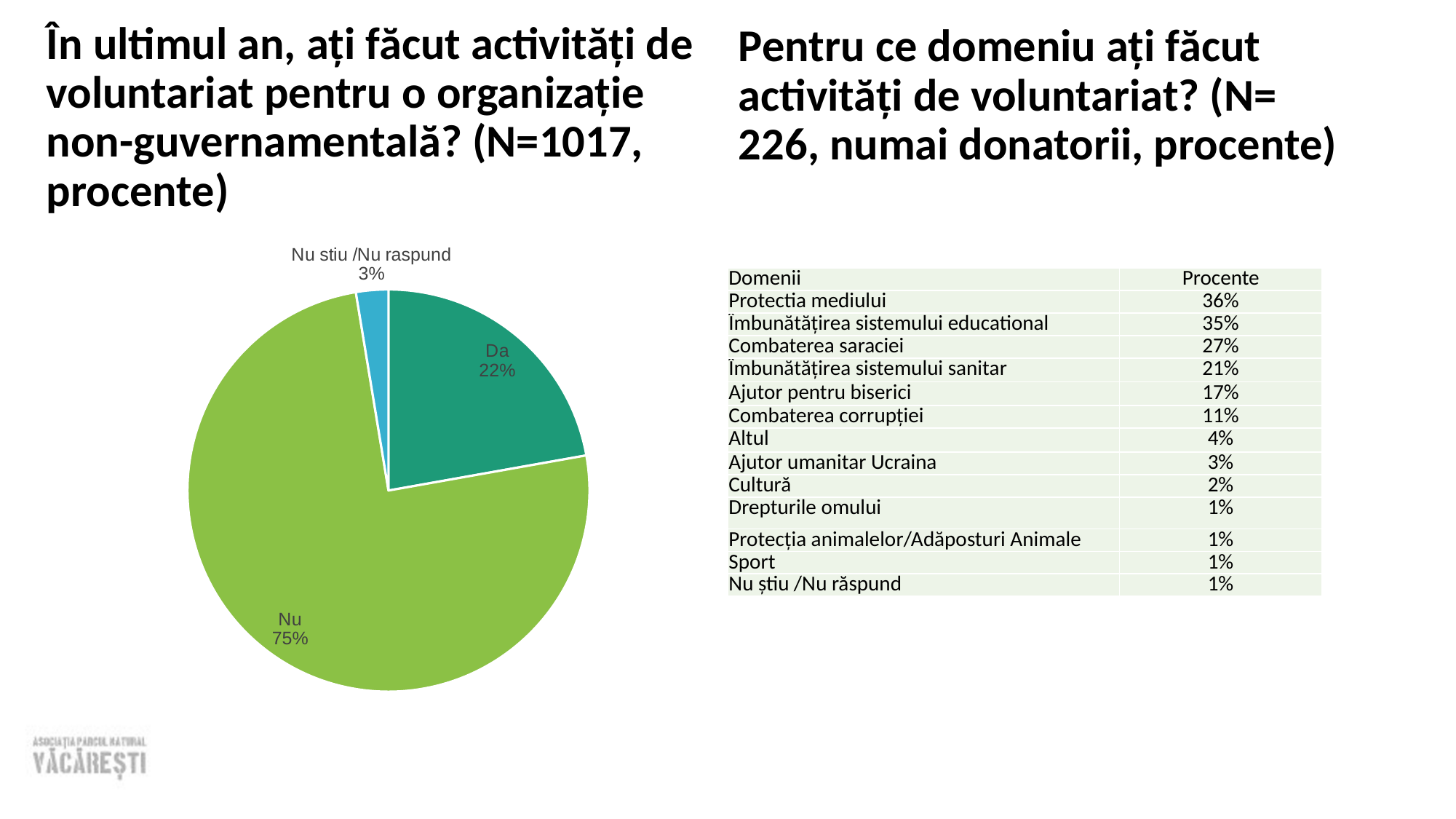
Which slice of the pie chart is the smallest? Nu stiu /Nu raspund What share of the pie chart is labelled "Nu"? 75% What share of the pie chart is labelled "Da"? 22% In the pie chart, what is the difference in percentage points between the "Nu" slice and the "Da" slice? 53 What is the sample size (N) stated in the title above the pie chart? 1017 How many slices does the pie chart have? 3 In the pie chart, what is the combined share of the "Da" and "Nu stiu /Nu raspund" slices? 25% In the pie chart, which is larger, the "Da" slice or the "Nu stiu /Nu raspund" slice? Da What kind of chart is shown on the left of the slide? Pie chart What colour is the "Nu" slice of the pie chart? Green What share of the pie chart is labelled "Nu stiu /Nu raspund"? 3% Which slice of the pie chart is the largest? Nu